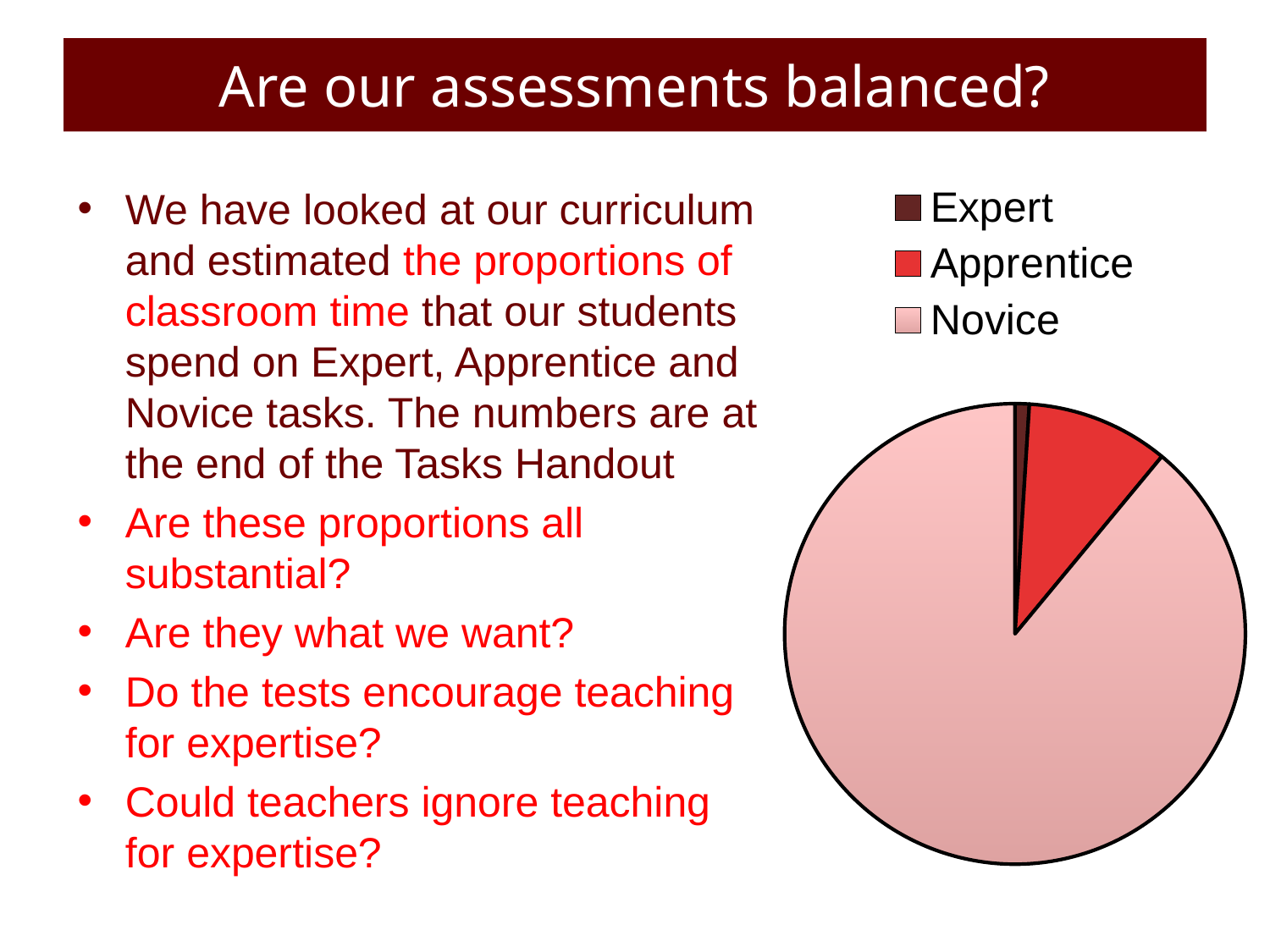
What are the three categories listed in the pie chart's legend, in order from top to bottom? Expert, Apprentice, Novice What kind of chart is shown on the slide? Pie chart Which slice is larger in the pie chart, Apprentice or Expert? Apprentice How many entries does the legend of the pie chart list? 3 Which category has the smallest slice of the pie chart? Expert Does the Novice slice take up more or less than half of the pie chart? More Which category is shown in the lightest pink colour in the pie chart? Novice How many slices does the pie chart have? 3 Which category has the largest slice of the pie chart? Novice Which slice is larger in the pie chart, Novice or Apprentice? Novice